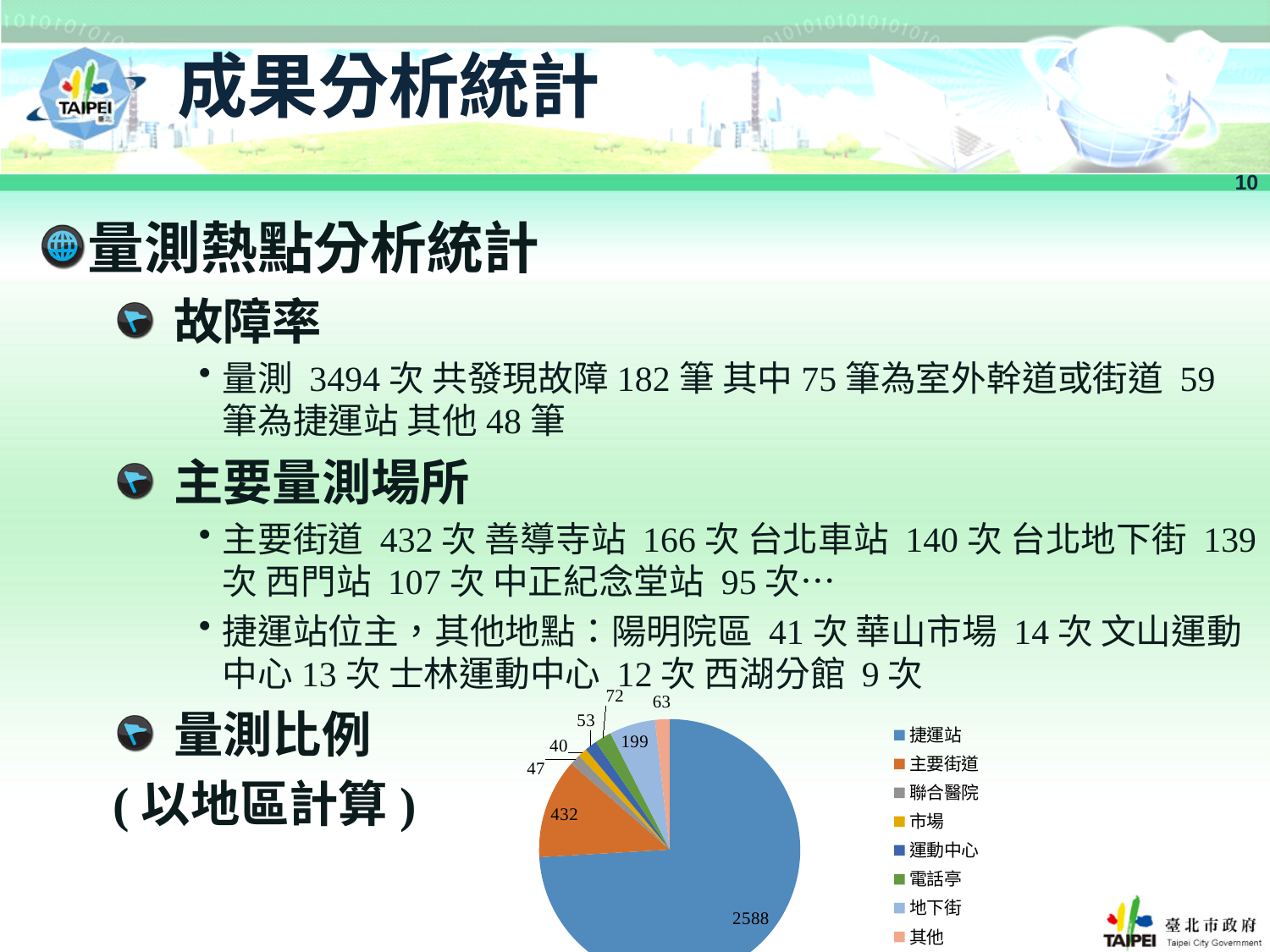
Which is larger, the value for 地下街 or the value for 電話亭? 地下街 What is the value for 主要街道 in the pie chart? 432 What is the value for 捷運站 in the pie chart? 2588 Which category has the largest slice in the pie chart? 捷運站 What is the value for 地下街 in the pie chart? 199 Which category has the smallest slice in the pie chart? 市場 What is the difference between the values for 捷運站 and 主要街道? 2156 What is the value for 電話亭 in the pie chart? 72 What is the value for 市場 in the pie chart? 40 How many categories does the pie chart legend list? 8 What is the total of all the values shown in the pie chart? 3494 What type of chart is shown on the slide? pie chart